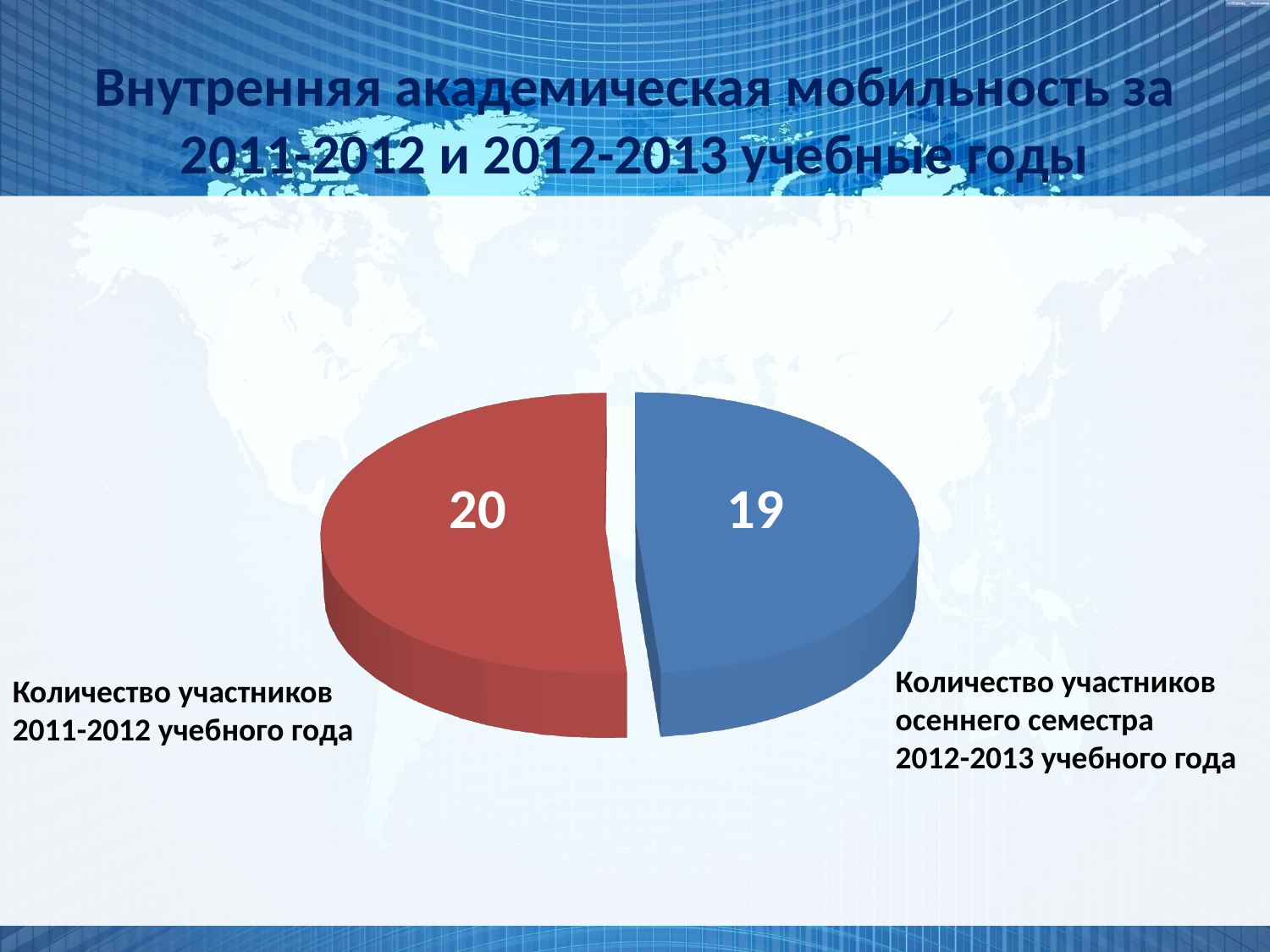
What is the value shown for the autumn semester 2012-2013 participants (Количество участников осеннего семестра 2012-2013 учебного года)? 19 What is the title of the slide containing the chart? Внутренняя академическая мобильность за 2011-2012 и 2012-2013 учебные годы Which category has the larger slice of the pie? Количество участников 2011-2012 учебного года Which category has the smaller slice of the pie? Количество участников осеннего семестра 2012-2013 учебного года How many slices does the pie chart have? 2 What kind of chart is shown on the slide? Pie chart What is the value shown for the 2011-2012 academic year participants (Количество участников 2011-2012 учебного года)? 20 What is the total number of participants across both slices of the pie? 39 What colour is the slice representing the 2011-2012 academic year participants? Red Which is larger: the number of participants in 2011-2012 or in the autumn semester of 2012-2013? 2011-2012 (20) What is the difference between the number of participants in 2011-2012 and in the autumn semester of 2012-2013? 1